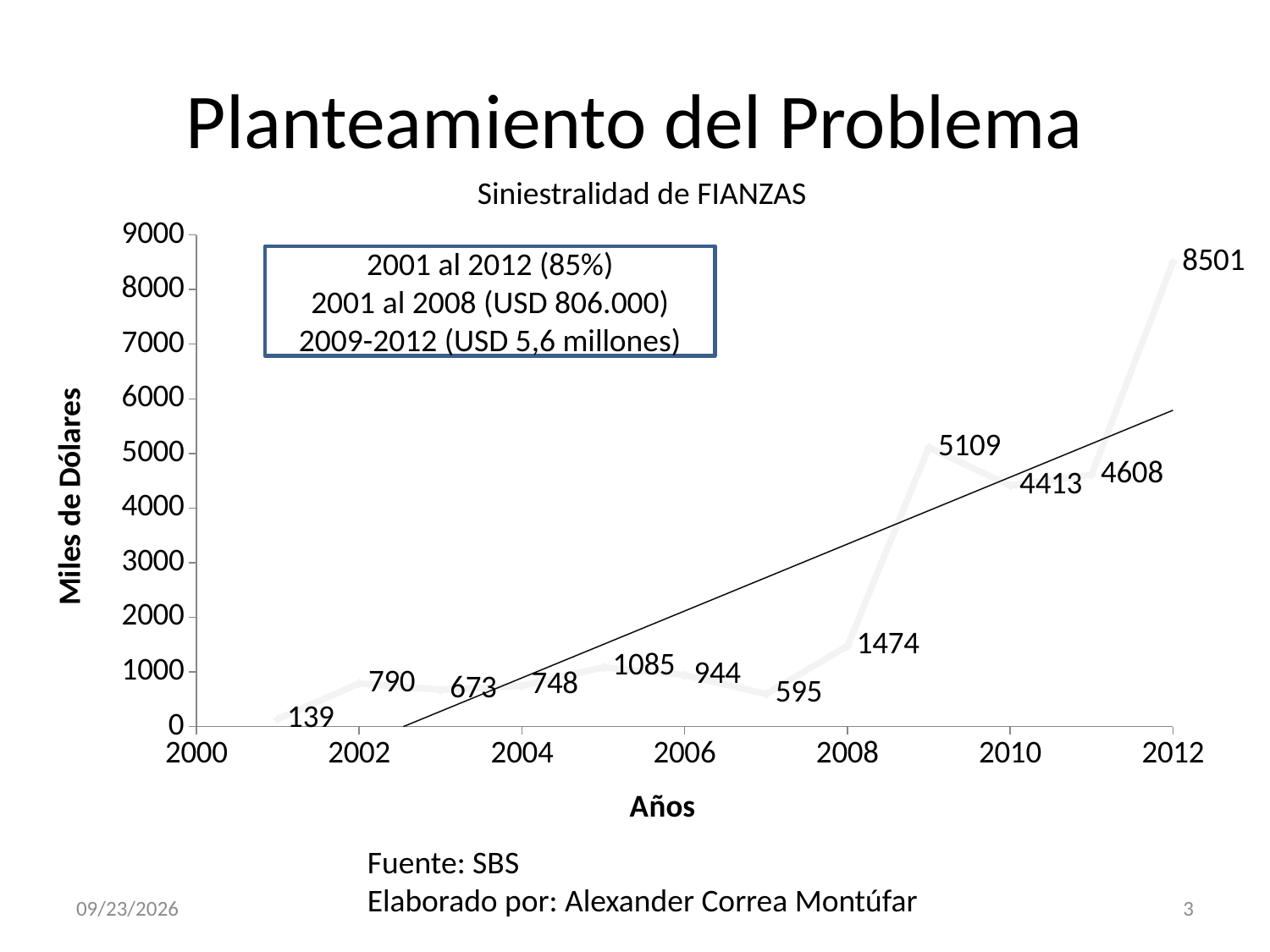
Which is larger in the Siniestralidad de FIANZAS chart, the value for 2010 or the value for 2011? 2011 Which year has the lowest value in the Siniestralidad de FIANZAS chart? 2001 How many years have data points plotted in the Siniestralidad de FIANZAS chart? 12 What is the difference between the values for 2012 and 2011 in the Siniestralidad de FIANZAS chart? 3893 What is the label of the vertical axis in the Siniestralidad de FIANZAS chart? Miles de Dólares Which year has the highest value in the Siniestralidad de FIANZAS chart? 2012 Is the value for 2007 in the Siniestralidad de FIANZAS chart greater or less than 1000? less What is the value for 2012 in the Siniestralidad de FIANZAS chart? 8501 What is the value for 2008 in the Siniestralidad de FIANZAS chart? 1474 What kind of chart is the Siniestralidad de FIANZAS chart? line chart What is the value for 2001 in the Siniestralidad de FIANZAS chart? 139 What is the value for 2009 in the Siniestralidad de FIANZAS chart? 5109